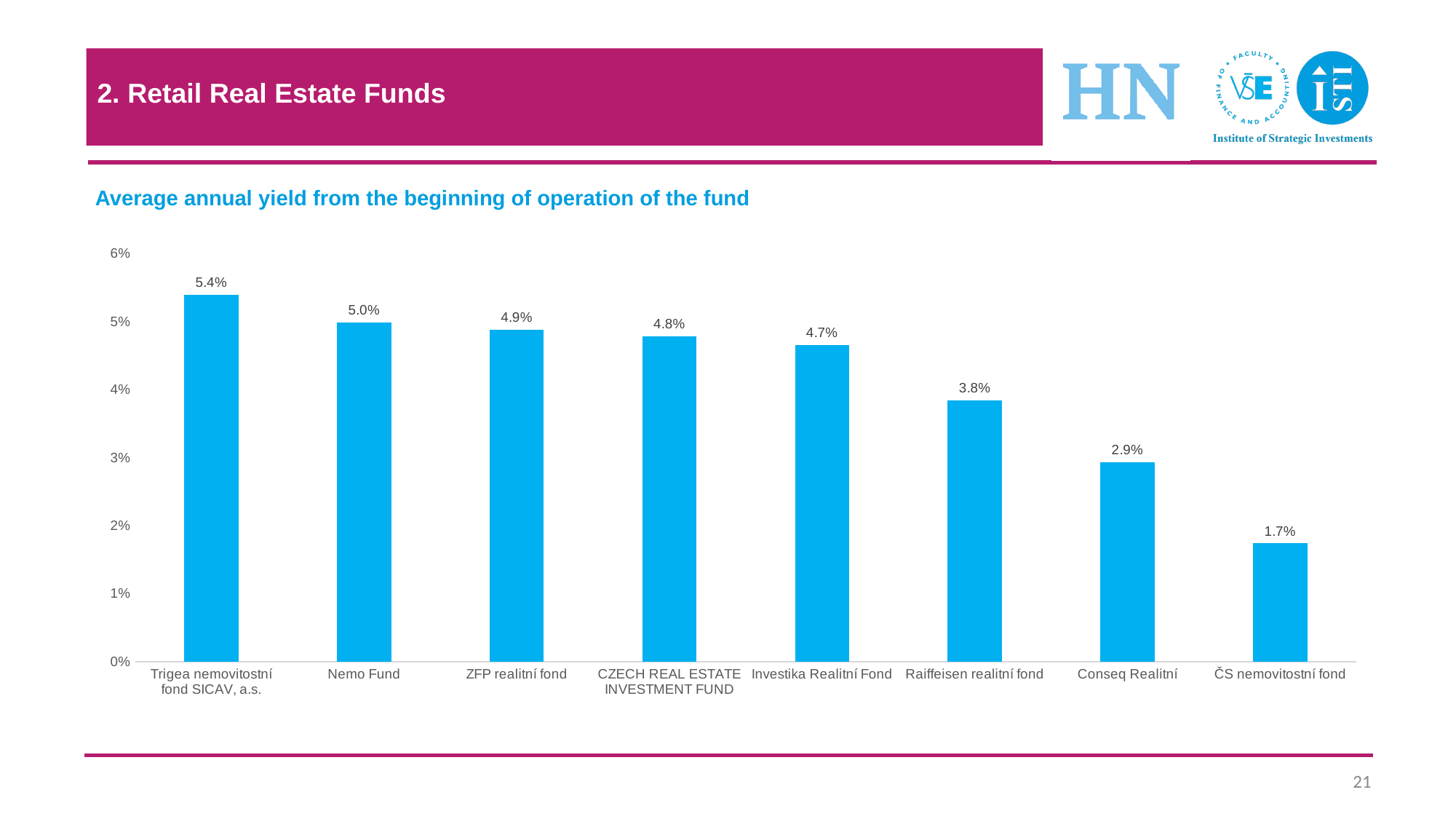
Do the values rise or fall from left to right along the x axis? fall Which fund has the lowest average annual yield? ČS nemovitostní fond What is the average annual yield for Raiffeisen realitní fond? 3.8% What kind of chart is shown on the slide? bar chart What is the average annual yield for ČS nemovitostní fond? 1.7% Is the value for CZECH REAL ESTATE INVESTMENT FUND greater or less than 4%? greater What is the difference between the yields of Trigea nemovitostní fond SICAV, a.s. and Conseq Realitní? 2.5% Which fund has the highest average annual yield? Trigea nemovitostní fond SICAV, a.s. How many funds are shown in the chart? 8 Which has a higher average annual yield, Conseq Realitní or Raiffeisen realitní fond? Raiffeisen realitní fond What is the average annual yield for Nemo Fund? 5.0% What is the difference between the yields of Investika Realitní Fond and Raiffeisen realitní fond? 0.9%